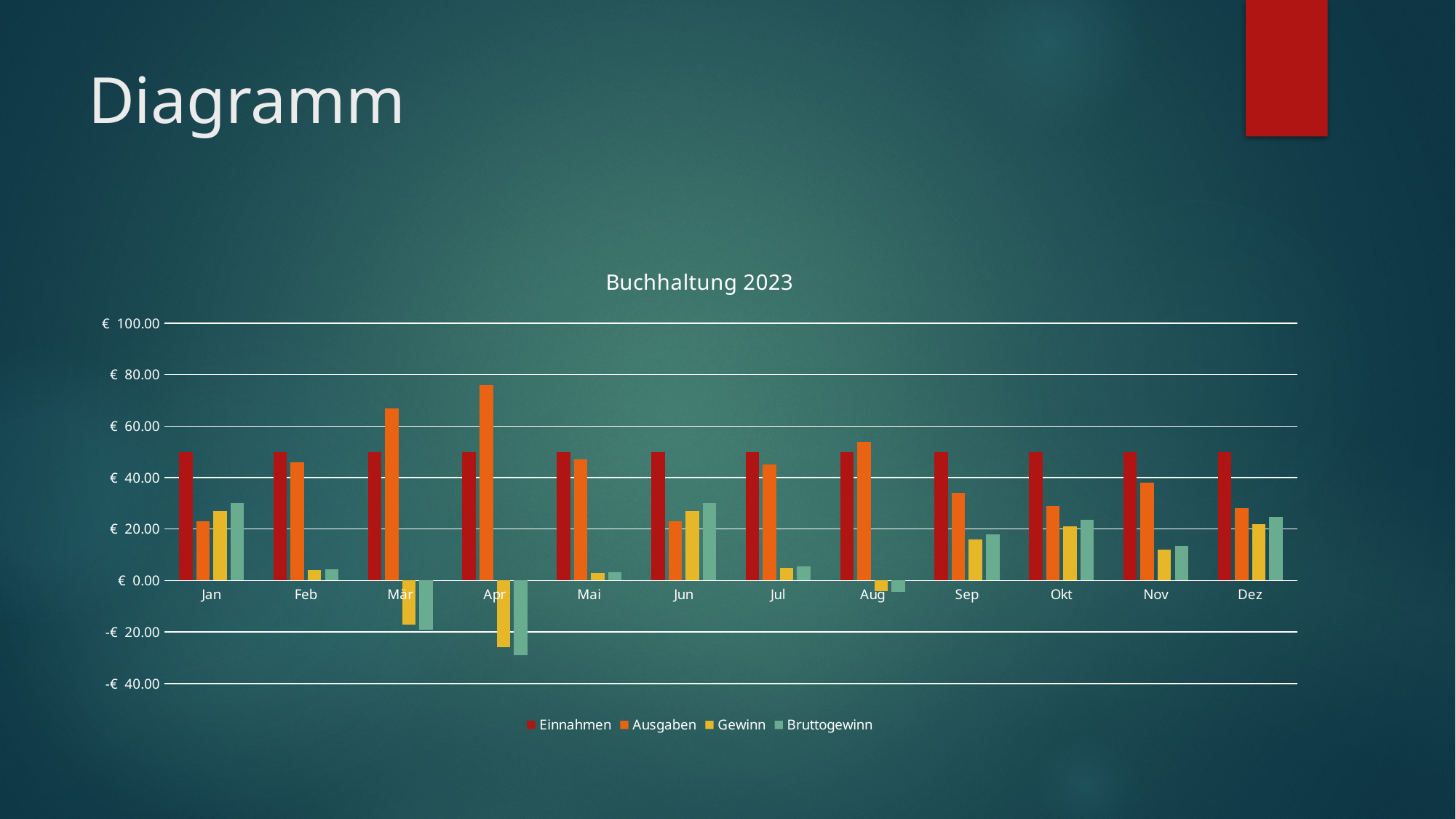
Which month has the lowest Gewinn value? Apr Is the Gewinn value for Apr greater or less than -€ 20.00? less How many months are shown on the x axis? 12 Which is larger, the Gewinn value for Jan or the Gewinn value for Jul? Jan Which is larger, the Ausgaben value for Okt or the Ausgaben value for Nov? Nov Do the Ausgaben values rise or fall from Jan to Apr? rise How many series does the legend list? 4 Is the Ausgaben value for Apr greater or less than € 60.00? greater What is the title of the chart? Buchhaltung 2023 What kind of chart is shown on the slide? bar chart Is the Ausgaben value for Sep greater or less than € 40.00? less Which month has the highest Ausgaben value? Apr